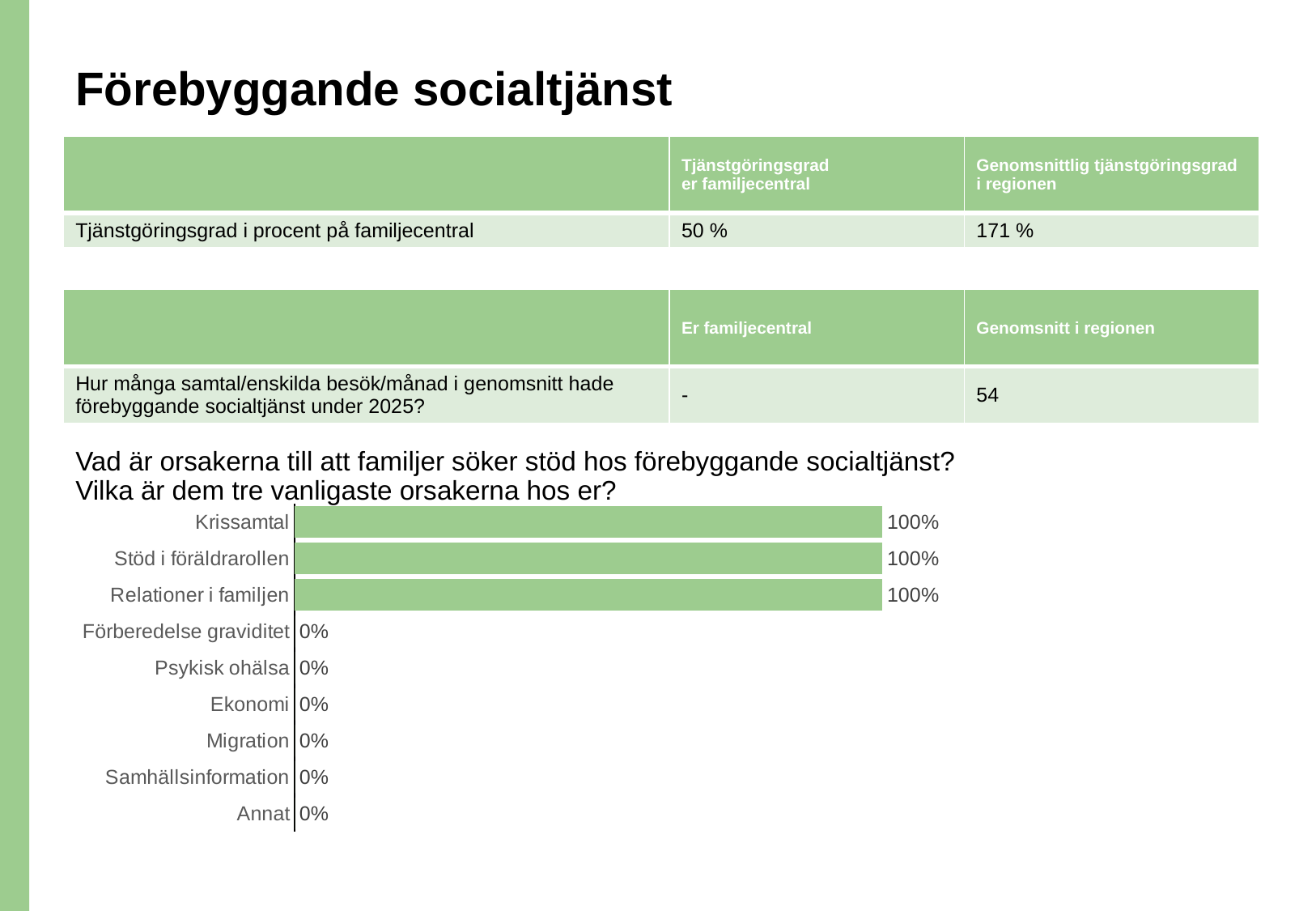
How many categories in the bar chart have a value of 0%? 6 What kind of chart is shown on the slide? bar chart What is the value for Migration in the bar chart? 0% What is the value for Psykisk ohälsa in the bar chart? 0% How many categories in the bar chart have a value of 100%? 3 Which category is listed first (at the top) in the bar chart? Krissamtal What is the value for Krissamtal in the bar chart? 100% Which is larger, the value for Krissamtal or the value for Annat? Krissamtal What is the difference between the values for Relationer i familjen and Ekonomi? 100% What is the value for Stöd i föräldrarollen in the bar chart? 100% How many categories are shown in the bar chart? 9 What is the value for Samhällsinformation in the bar chart? 0%